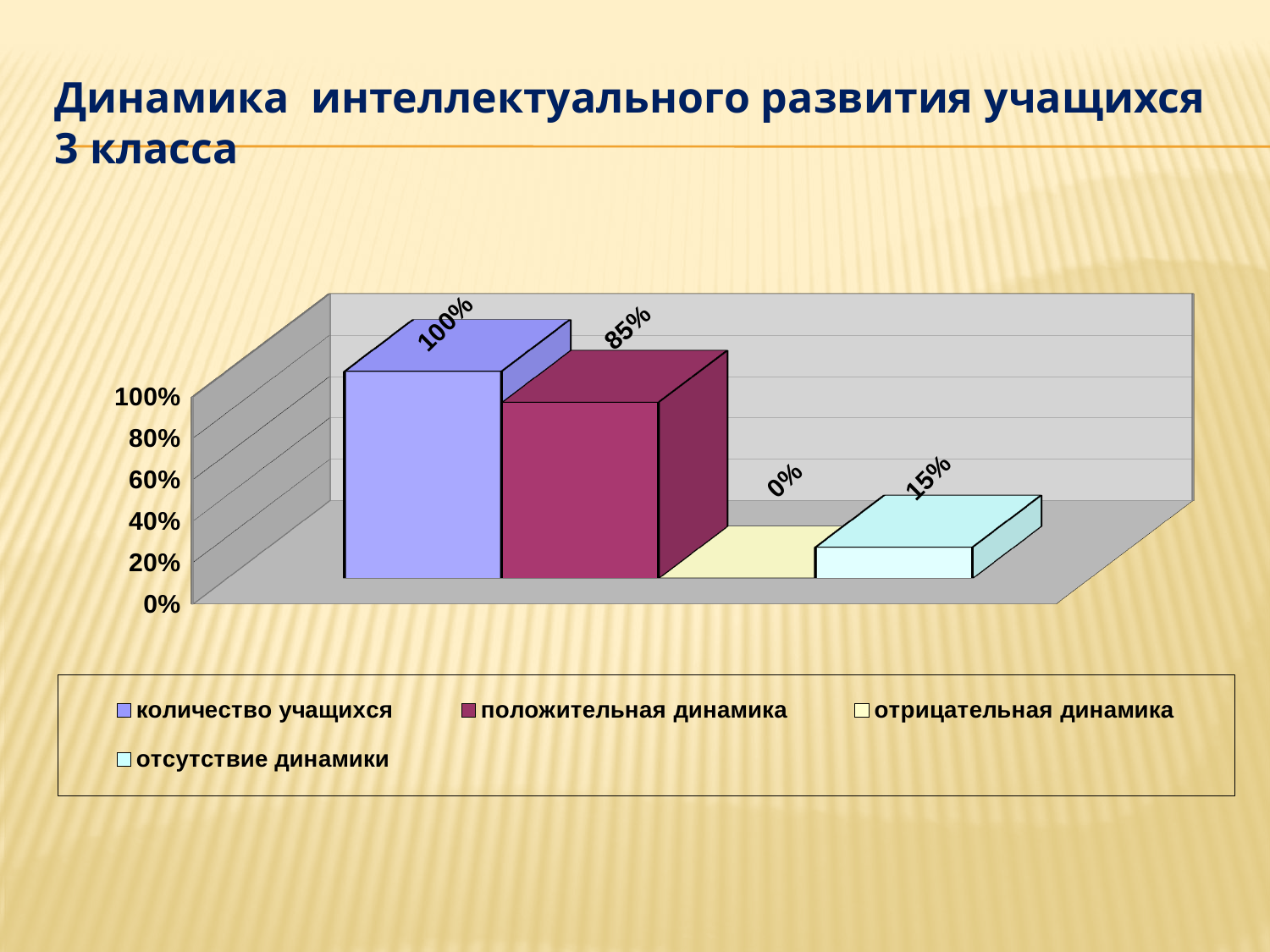
Is the value for положительная динамика greater or less than 80%? greater What is the value for отрицательная динамика? 0% What is the value for количество учащихся? 100% What is the value for положительная динамика? 85% Which series has the highest value? количество учащихся What is the title of the slide? Динамика интеллектуального развития учащихся 3 класса What is the value for отсутствие динамики? 15% Which is larger, положительная динамика or отсутствие динамики? положительная динамика How many series does the legend list? 4 What kind of chart is shown on the slide? bar chart Which series has the lowest value? отрицательная динамика What is the difference between положительная динамика and отсутствие динамики? 70%